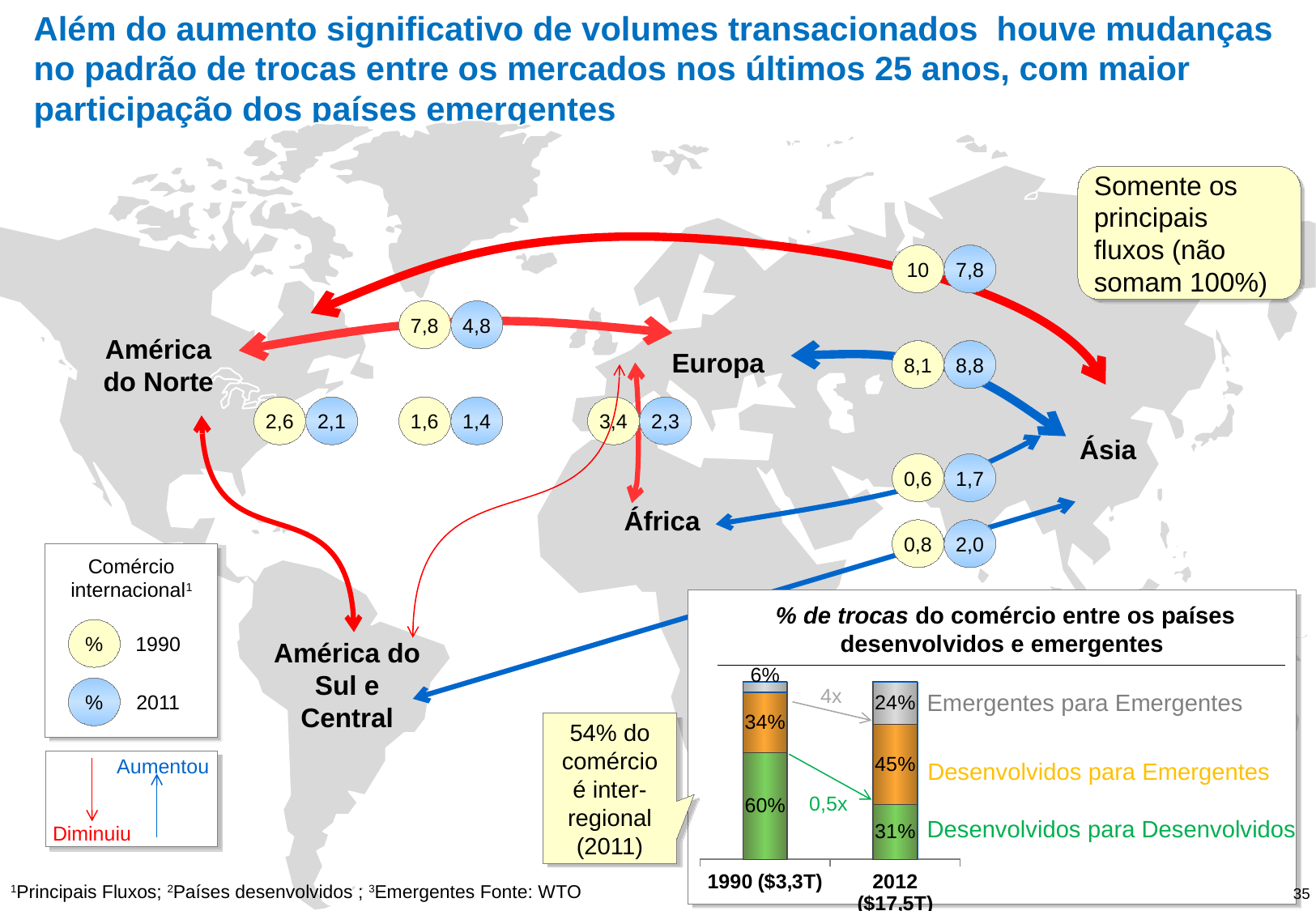
In the chart '% de trocas do comércio entre os países desenvolvidos e emergentes', what is the value for 'Desenvolvidos para Emergentes' in 1990? 34% In the chart '% de trocas do comércio entre os países desenvolvidos e emergentes', how many series are listed in the legend? 3 In the chart '% de trocas do comércio entre os países desenvolvidos e emergentes', what is the difference between 'Desenvolvidos para Desenvolvidos' in 1990 and in 2012? 29% In the chart '% de trocas do comércio entre os países desenvolvidos e emergentes', which segment is the smallest in the 1990 bar? Emergentes para Emergentes In the chart '% de trocas do comércio entre os países desenvolvidos e emergentes', what is the total trade value shown for 2012? $17,5T In the chart '% de trocas do comércio entre os países desenvolvidos e emergentes', what is the value for 'Emergentes para Emergentes' in 2012? 24% In the chart '% de trocas do comércio entre os países desenvolvidos e emergentes', which segment is the largest in the 2012 bar? Desenvolvidos para Emergentes In the chart '% de trocas do comércio entre os países desenvolvidos e emergentes', what is the value for 'Desenvolvidos para Desenvolvidos' in 2012? 31% In the chart '% de trocas do comércio entre os países desenvolvidos e emergentes', is 'Desenvolvidos para Emergentes' larger in 1990 or in 2012? 2012 In the chart '% de trocas do comércio entre os países desenvolvidos e emergentes', how many bars are shown? 2 In the chart '% de trocas do comércio entre os países desenvolvidos e emergentes', what is the value for 'Desenvolvidos para Desenvolvidos' in 1990? 60% What kind of chart is '% de trocas do comércio entre os países desenvolvidos e emergentes'? Stacked bar chart